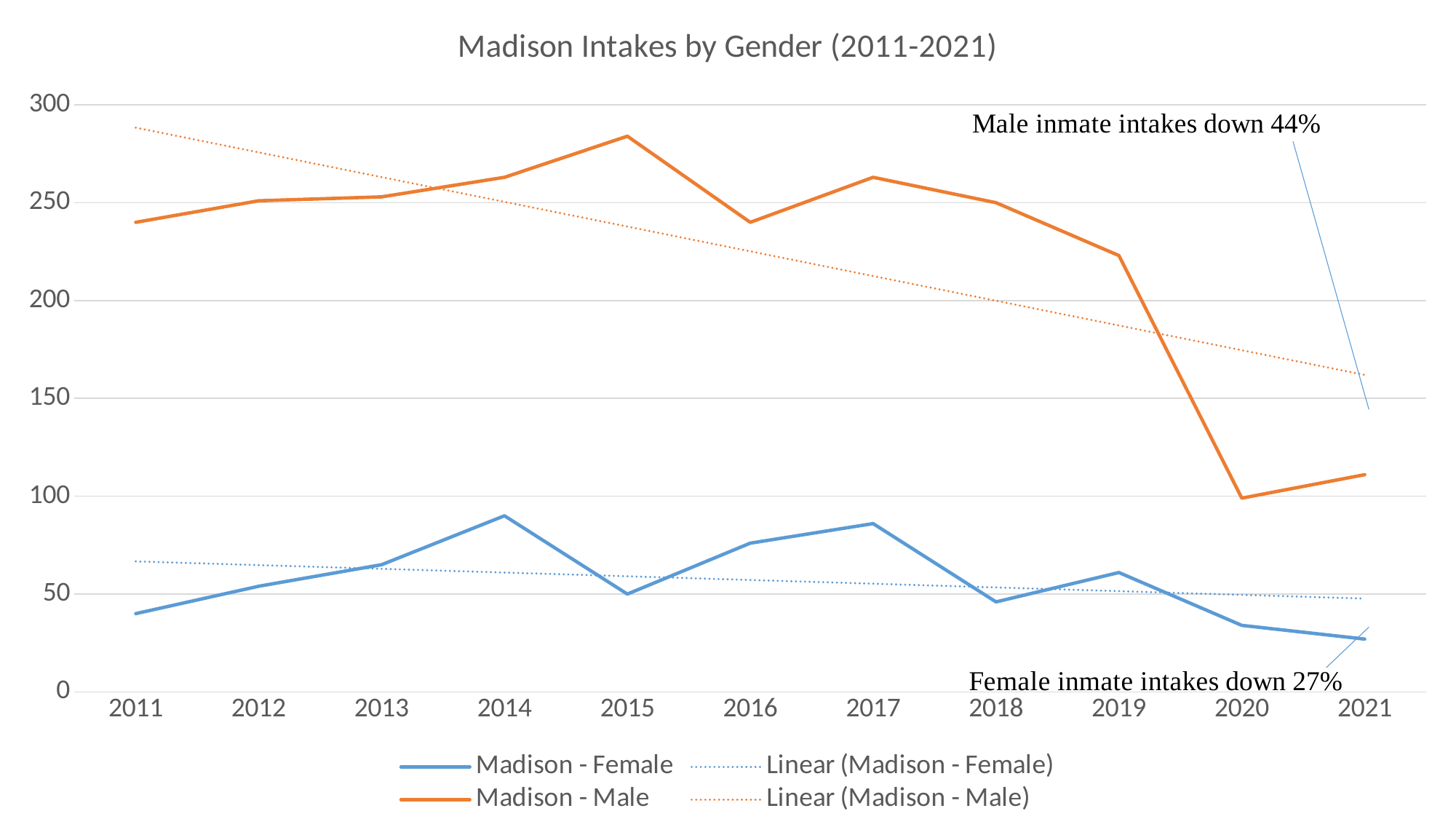
In 2015, which series has the larger value, Madison - Male or Madison - Female? Madison - Male In which year is the Madison - Male series at its highest? 2015 Is the value for Madison - Male in 2020 greater or less than 150? less In which year is the Madison - Male series at its lowest? 2020 What is the title of the chart? Madison Intakes by Gender (2011-2021) Is the value for Madison - Female in 2014 greater or less than 50? greater How many entries does the legend list? 4 Is the value for Madison - Male in 2011 greater or less than 200? greater How many years are shown on the x axis? 11 In which year is the Madison - Female series at its lowest? 2021 According to the annotation on the chart, by what percentage are male inmate intakes down? 44% What kind of chart is shown on the slide? line chart